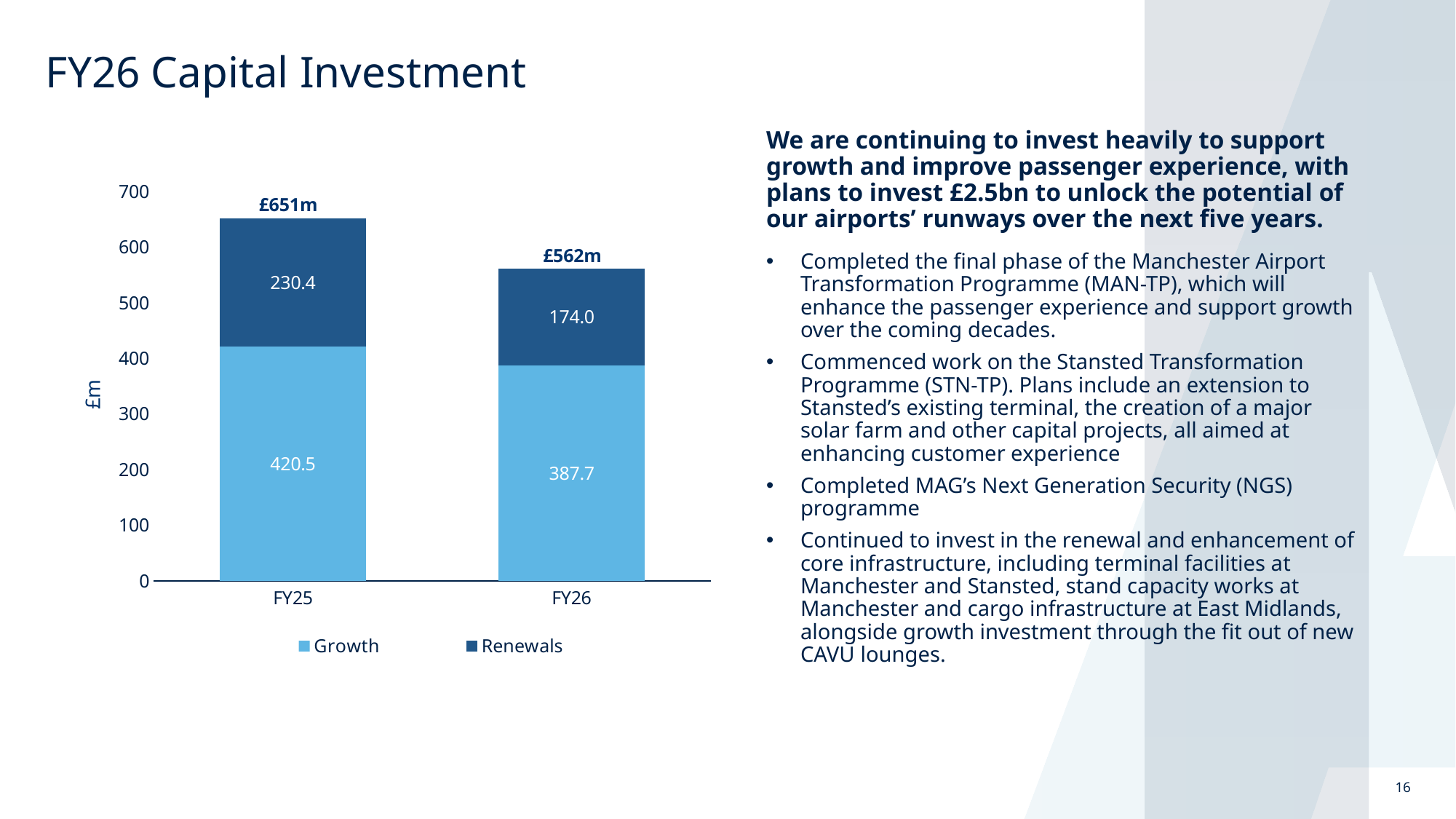
What is the Growth value for FY25? 420.5 What is the difference between the Growth values for FY25 and FY26? 32.8 What is the label on the vertical axis of the chart? £m What is the total labelled above the FY25 stacked bar? £651m Which year has the larger Renewals value, FY25 or FY26? FY25 What is the Renewals value for FY26? 174.0 What is the difference between the Renewals values for FY25 and FY26? 56.4 What is the Renewals value for FY25? 230.4 What is the Growth value for FY26? 387.7 What is the total labelled above the FY26 stacked bar? £562m What kind of chart is shown on the slide? Stacked bar chart How many series does the legend list? 2